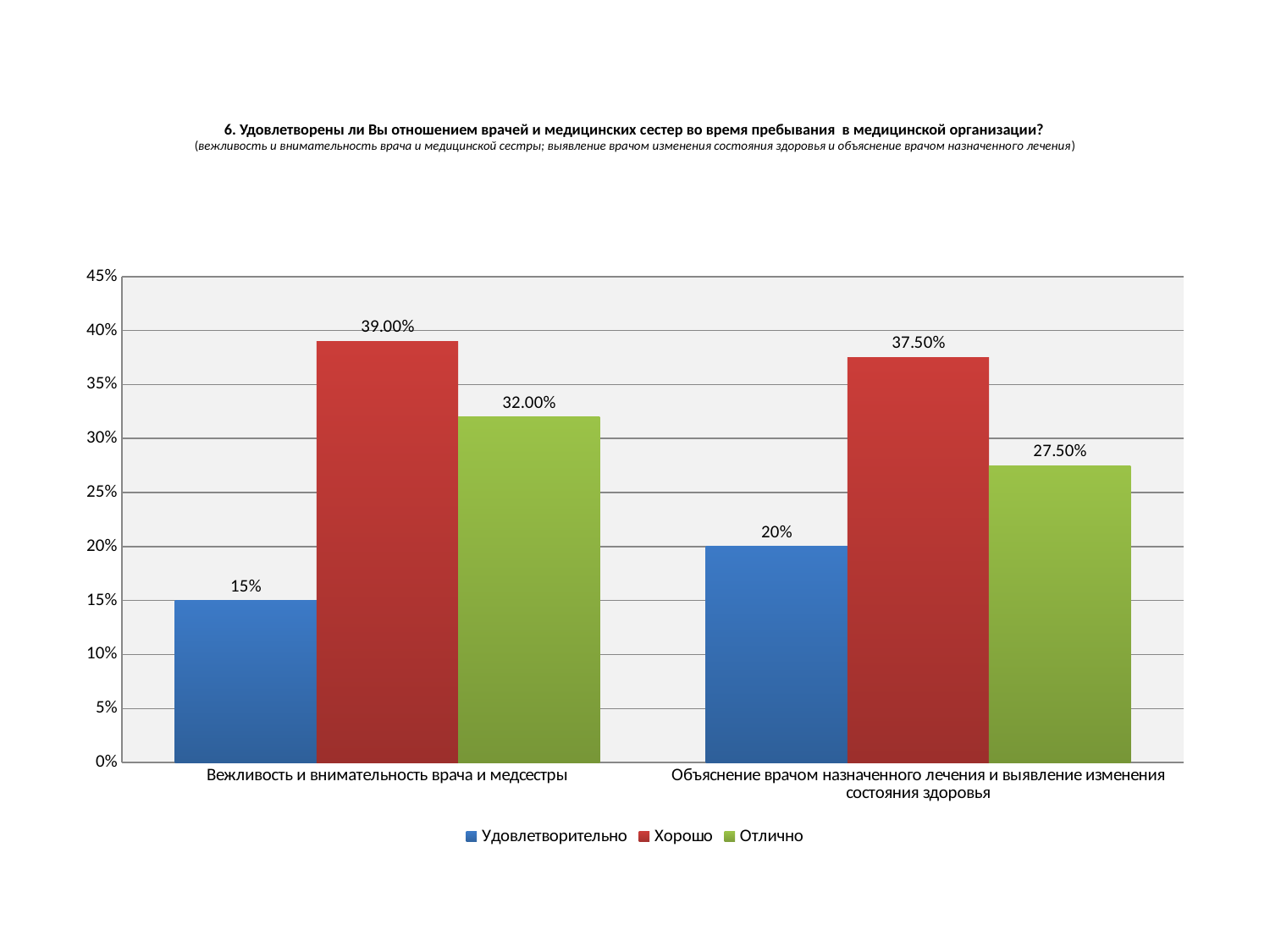
What kind of chart is shown on the slide? bar chart What is the value for "Отлично" in the "Объяснение врачом назначенного лечения и выявление изменения состояния здоровья" category? 27.50% Which series has the lowest value in the "Объяснение врачом назначенного лечения и выявление изменения состояния здоровья" category? Удовлетворительно Which series has the highest value in the "Вежливость и внимательность врача и медсестры" category? Хорошо What is the value for "Удовлетворительно" in the "Объяснение врачом назначенного лечения и выявление изменения состояния здоровья" category? 20% How many series does the legend list? 3 Is the "Хорошо" value for "Объяснение врачом назначенного лечения и выявление изменения состояния здоровья" greater or less than 35%? greater How many categories are shown on the x axis? 2 What is the value for "Хорошо" in the "Вежливость и внимательность врача и медсестры" category? 39.00% What is the value for "Удовлетворительно" in the "Вежливость и внимательность врача и медсестры" category? 15% What is the difference between the "Хорошо" and "Отлично" values in the "Вежливость и внимательность врача и медсестры" category? 7.00% Which is larger: the "Отлично" value for "Вежливость и внимательность врача и медсестры" or the "Отлично" value for "Объяснение врачом назначенного лечения и выявление изменения состояния здоровья"? Вежливость и внимательность врача и медсестры